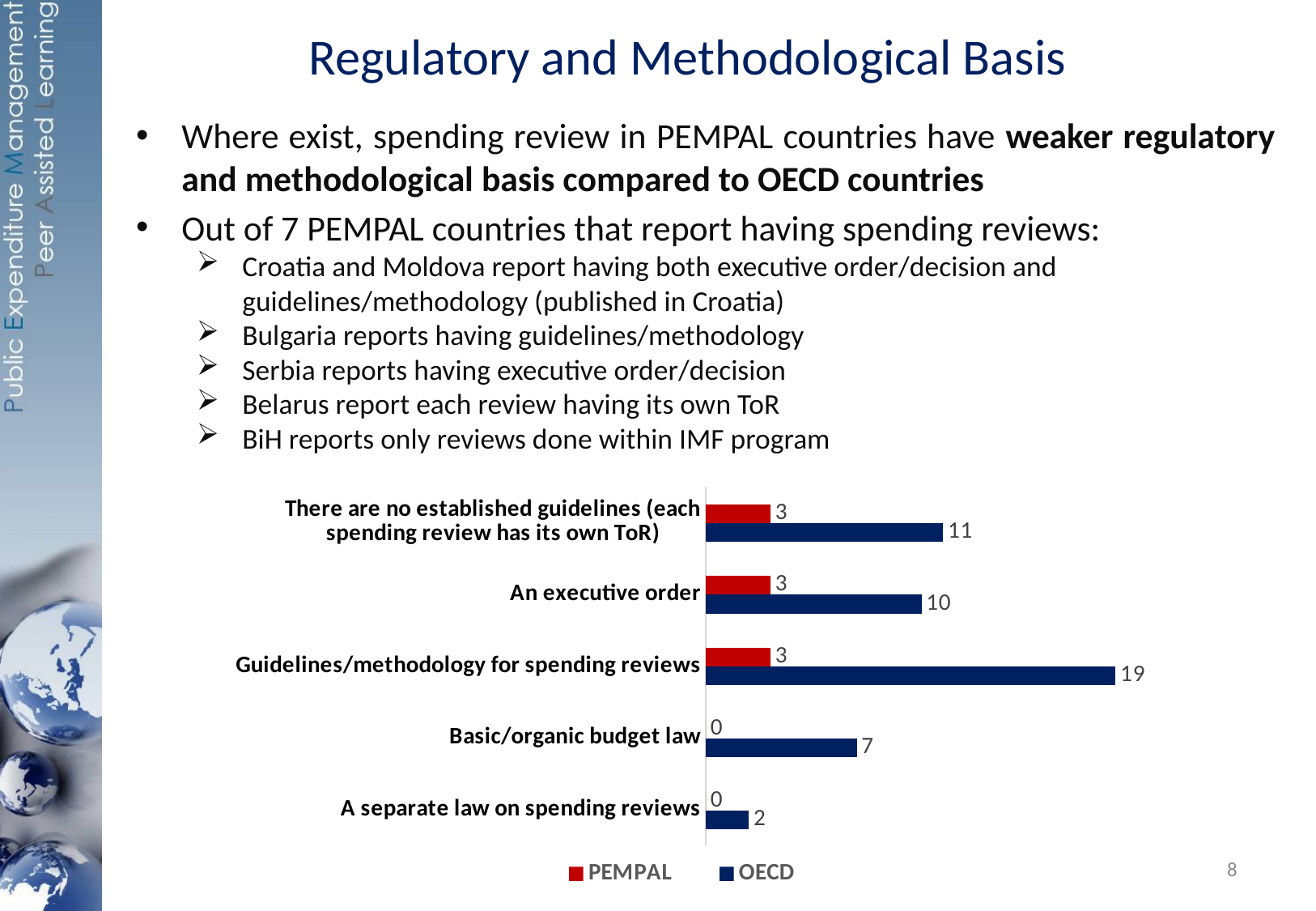
What is the OECD value for Basic/organic budget law? 7 How many categories are shown in the chart? 5 Which category has the lowest OECD value? A separate law on spending reviews What is the OECD value for Guidelines/methodology for spending reviews? 19 What is the PEMPAL value for A separate law on spending reviews? 0 Which category has the highest OECD value? Guidelines/methodology for spending reviews Which series is shown in red in the chart? PEMPAL What is the difference between the OECD and PEMPAL values for Guidelines/methodology for spending reviews? 16 Which is larger: the OECD value for An executive order or the OECD value for Basic/organic budget law? An executive order How many series does the legend list? 2 What is the PEMPAL value for An executive order? 3 What kind of chart is shown on the slide? Bar chart